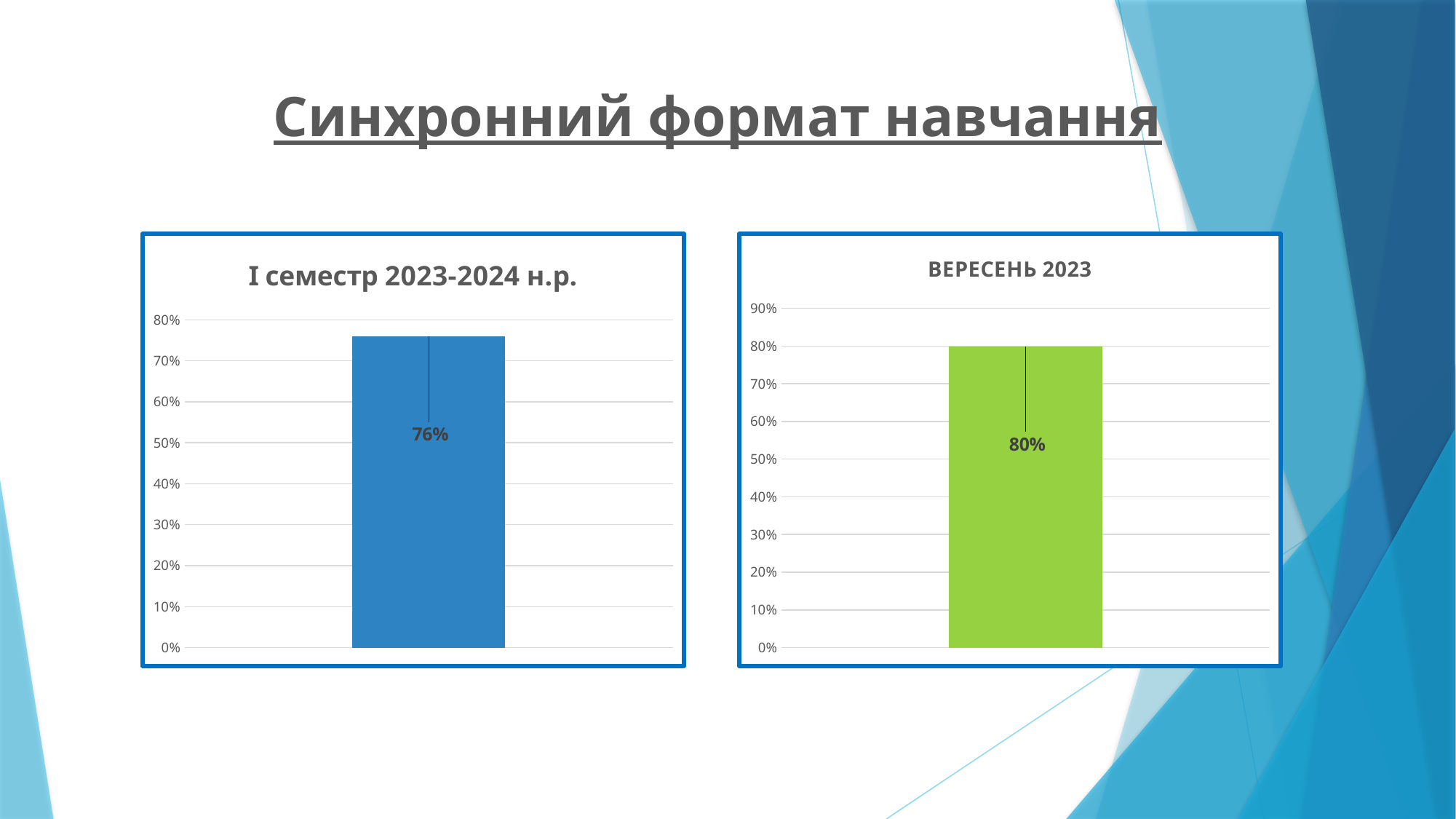
In the chart titled "ВЕРЕСЕНЬ 2023", what value is printed on the bar? 80% How many bars are plotted in the chart titled "ВЕРЕСЕНЬ 2023"? 1 What kind of chart is the right chart, "ВЕРЕСЕНЬ 2023"? bar chart How many bars are plotted in the chart titled "І семестр 2023-2024 н.р."? 1 What kind of chart is the left chart, "І семестр 2023-2024 н.р."? bar chart What is the difference between the value in the "ВЕРЕСЕНЬ 2023" chart and the value in the "І семестр 2023-2024 н.р." chart? 4% What is the title of the left chart on the slide? І семестр 2023-2024 н.р. Which chart shows the larger value: "І семестр 2023-2024 н.р." or "ВЕРЕСЕНЬ 2023"? ВЕРЕСЕНЬ 2023 In the chart titled "І семестр 2023-2024 н.р.", is the bar's value greater or less than 70%? greater What colour is the bar in the chart titled "ВЕРЕСЕНЬ 2023"? green In the chart titled "ВЕРЕСЕНЬ 2023", is the bar's value greater or less than 90%? less In the chart titled "І семестр 2023-2024 н.р.", what value is printed on the bar? 76%